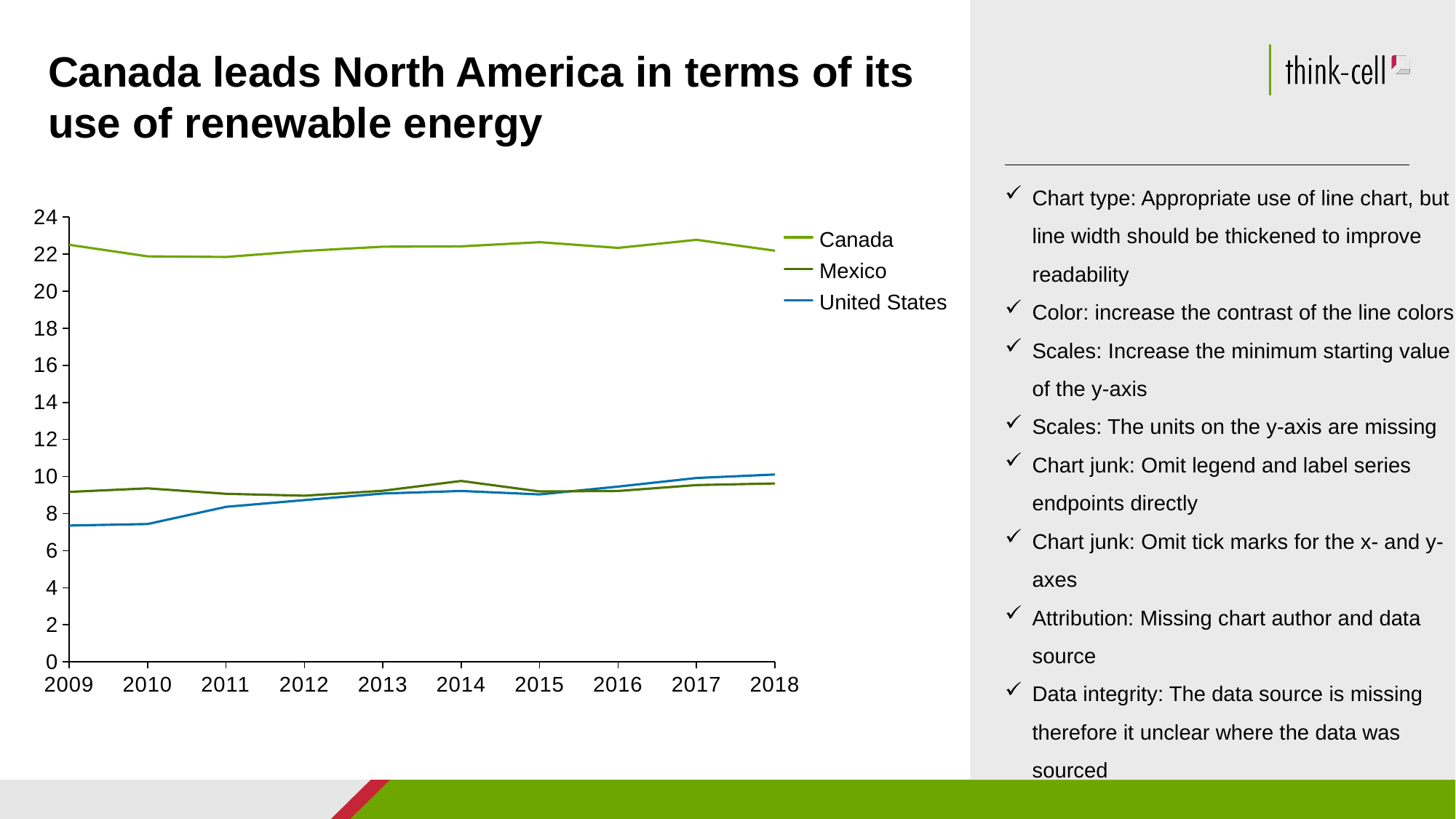
Does the United States line rise or fall from 2009 to 2018? rise Is the value for Canada in 2017 greater or less than 22? greater Is the value for United States in 2009 greater or less than 8? less What kind of chart is shown on the slide? line chart Is the value for Mexico in 2009 greater or less than 8? greater How many years are shown on the x axis? 10 Which series has the highest values across all years? Canada What is the first year shown on the x axis? 2009 How many series does the legend list? 3 Which is larger in 2009, the value for Mexico or the value for United States? Mexico Which series has the lowest value in 2009? United States